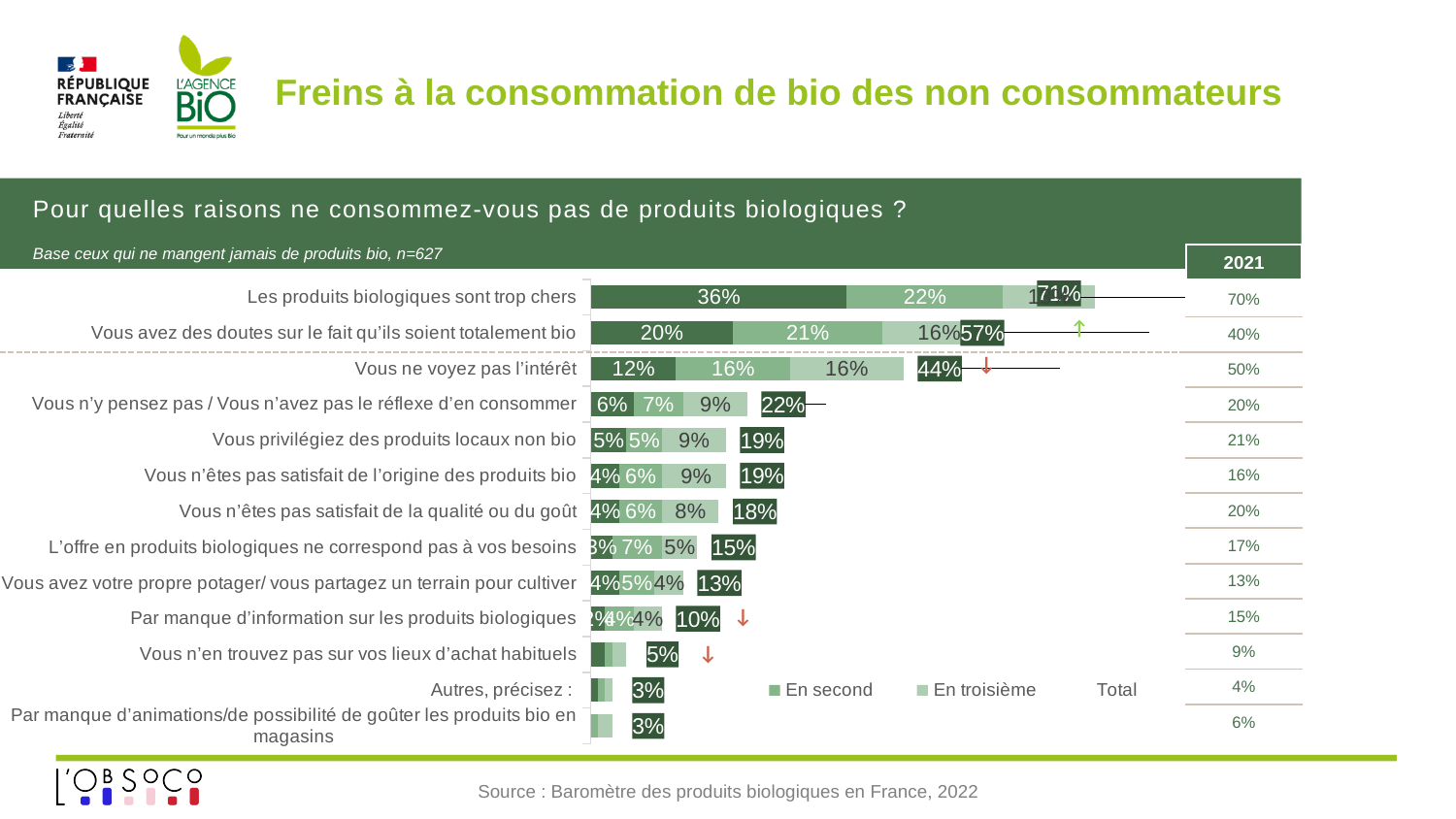
How many reasons (categories) are listed in the chart? 13 By how many percentage points does the total for "Vous ne voyez pas l'intérêt" (44%) differ from its 2021 value (50%)? 6 points By how many percentage points did the total for "Vous avez des doutes sur le fait qu'ils soient totalement bio" (57%) change compared with 2021 (40%)? 17 points What is the value of the first (dark green) segment for "Vous avez des doutes sur le fait qu'ils soient totalement bio"? 20% Which reason has the highest total value? Les produits biologiques sont trop chers What is the 2021 value shown for "Vous avez des doutes sur le fait qu'ils soient totalement bio"? 40% What is the sample size (n) indicated for the base of the chart? n=627 What is the "En second" value for "Vous ne voyez pas l'intérêt"? 16% What is the total value shown for "Les produits biologiques sont trop chers"? 71% What kind of chart is used to show the reasons for not consuming organic products? Bar chart What is the total value shown for "Vous n'en trouvez pas sur vos lieux d'achat habituels"? 5% Which has the larger total: "Vous n'y pensez pas / Vous n'avez pas le réflexe d'en consommer" or "Vous privilégiez des produits locaux non bio"? Vous n'y pensez pas / Vous n'avez pas le réflexe d'en consommer